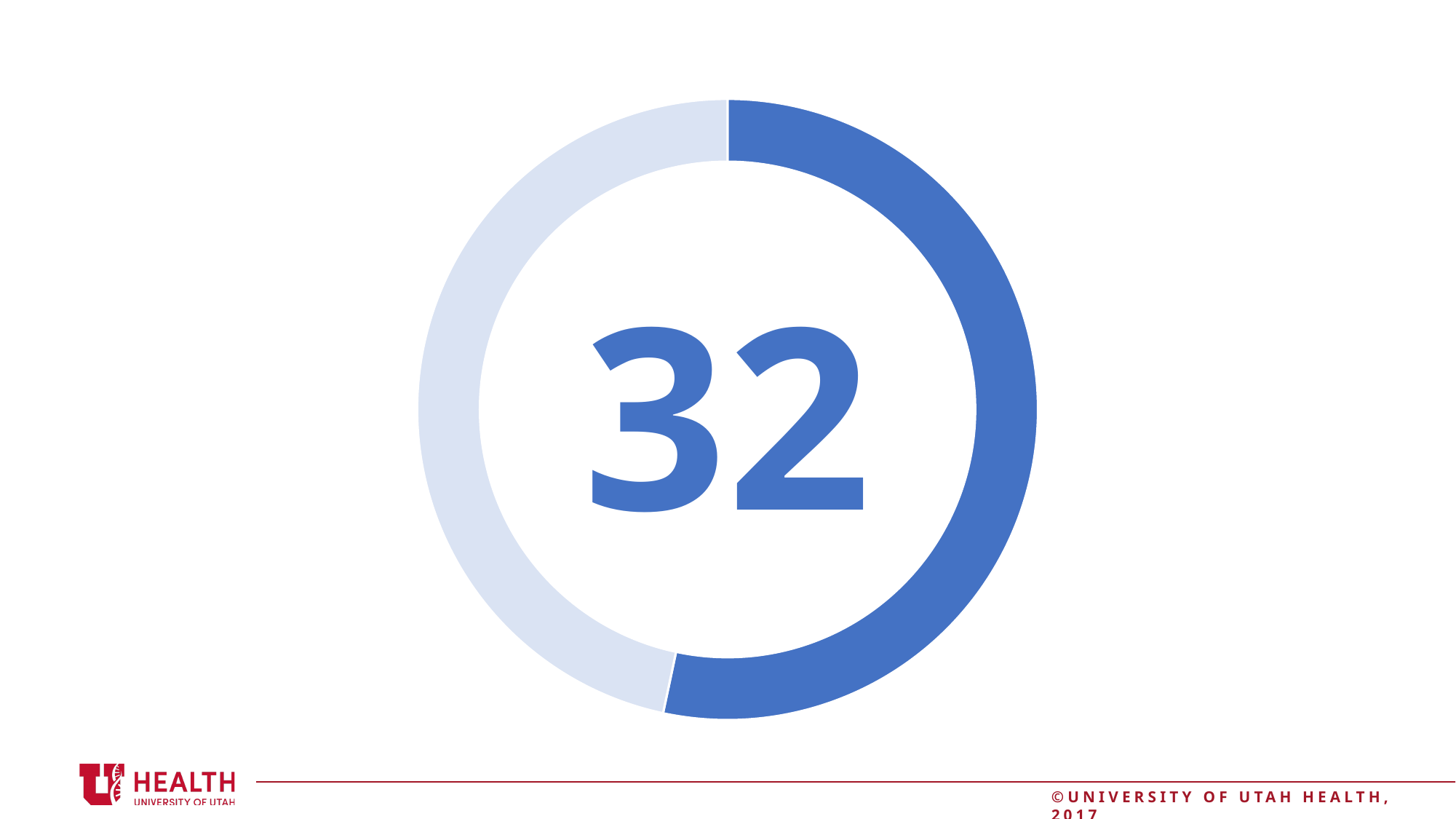
Which segment of the doughnut chart is larger, the dark blue one or the light blue one? dark blue Does the doughnut chart have a legend? No What number is displayed in the centre of the doughnut chart? 32 How many segments does the doughnut chart have? 2 What kind of chart is shown on the slide? doughnut chart